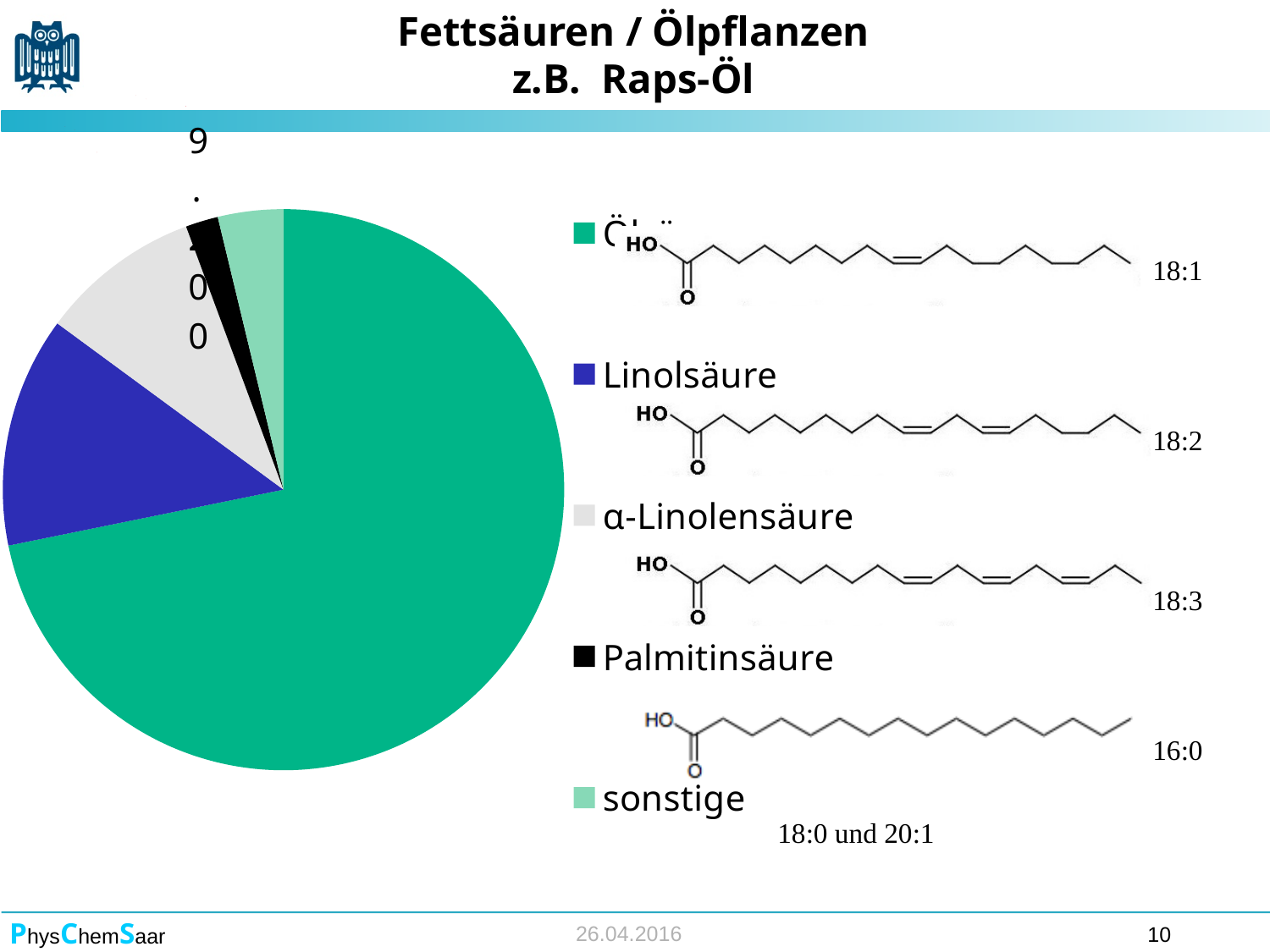
How many categories does the pie chart's legend list? 5 Which slice is larger, α-Linolensäure or sonstige? α-Linolensäure Which slice is larger, Palmitinsäure or sonstige? sonstige Is the Linolsäure slice the largest slice in the pie chart? No What is the title of the slide containing the pie chart? Fettsäuren / Ölpflanzen z.B. Raps-Öl Which category has the smallest slice in the pie chart? Palmitinsäure What colour is the Palmitinsäure slice in the pie chart? black What kind of chart is shown on the slide? pie chart